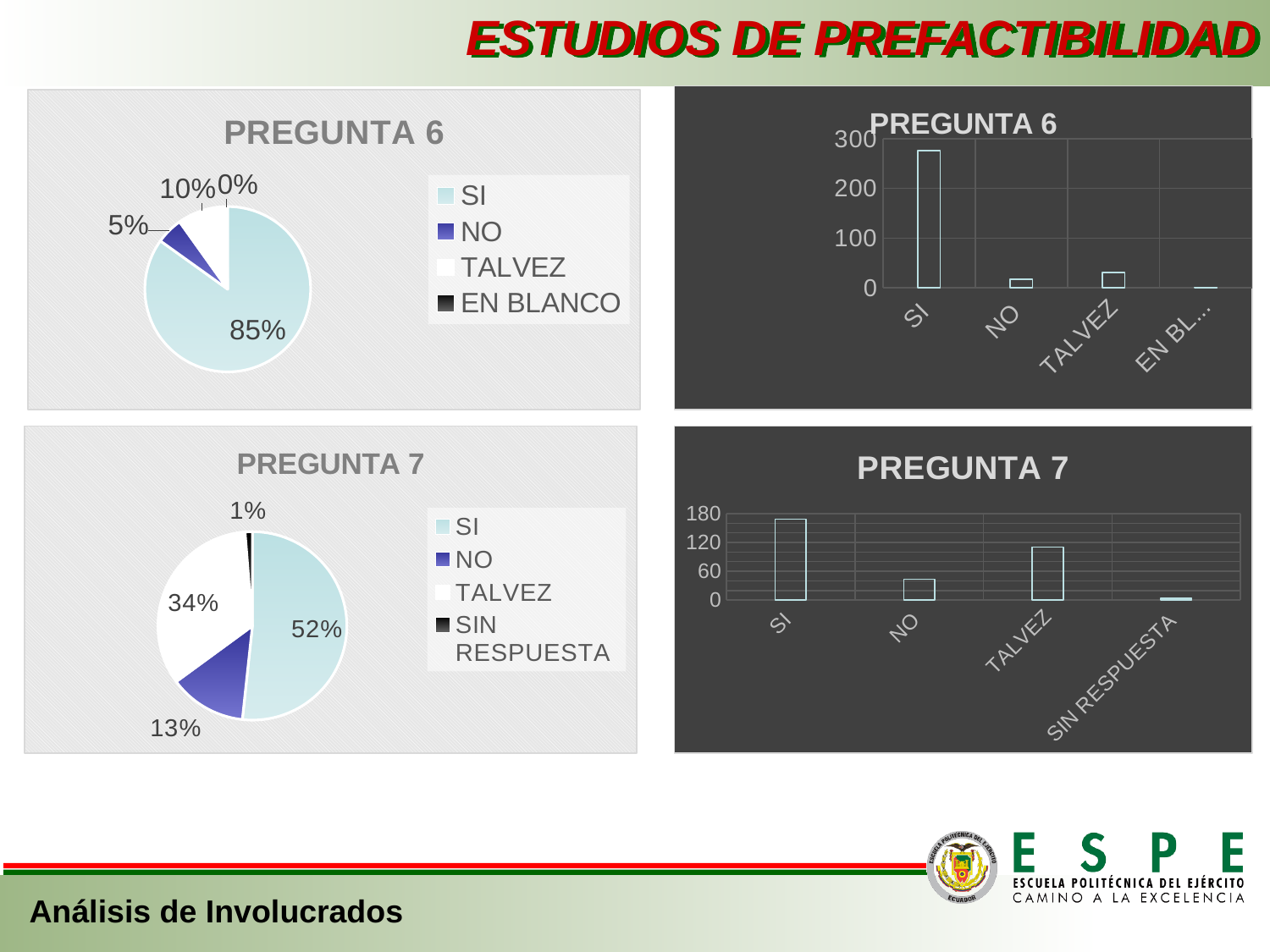
In the PREGUNTA 6 pie chart (top left), which is larger, NO or TALVEZ? TALVEZ What kind of chart is the PREGUNTA 6 chart on the top right of the slide? Bar chart In the PREGUNTA 7 bar chart (bottom right), which category has the lowest value? SIN RESPUESTA In the PREGUNTA 6 bar chart (top right), is the value for SI greater or less than 200? greater In the PREGUNTA 7 pie chart (bottom left), which category has the smallest share? SIN RESPUESTA In the PREGUNTA 7 pie chart (bottom left), what is the difference in percentage points between SI and TALVEZ? 18 In the PREGUNTA 7 bar chart (bottom right), is the value for TALVEZ greater or less than 60? greater In the PREGUNTA 6 pie chart (top left), what share does SI have? 85% In the PREGUNTA 6 pie chart (top left), what share does TALVEZ have? 10% In the PREGUNTA 7 pie chart (bottom left), which category has the largest share? SI How many categories are shown in the PREGUNTA 7 bar chart (bottom right)? 4 In the PREGUNTA 7 pie chart (bottom left), what share does NO have? 13%